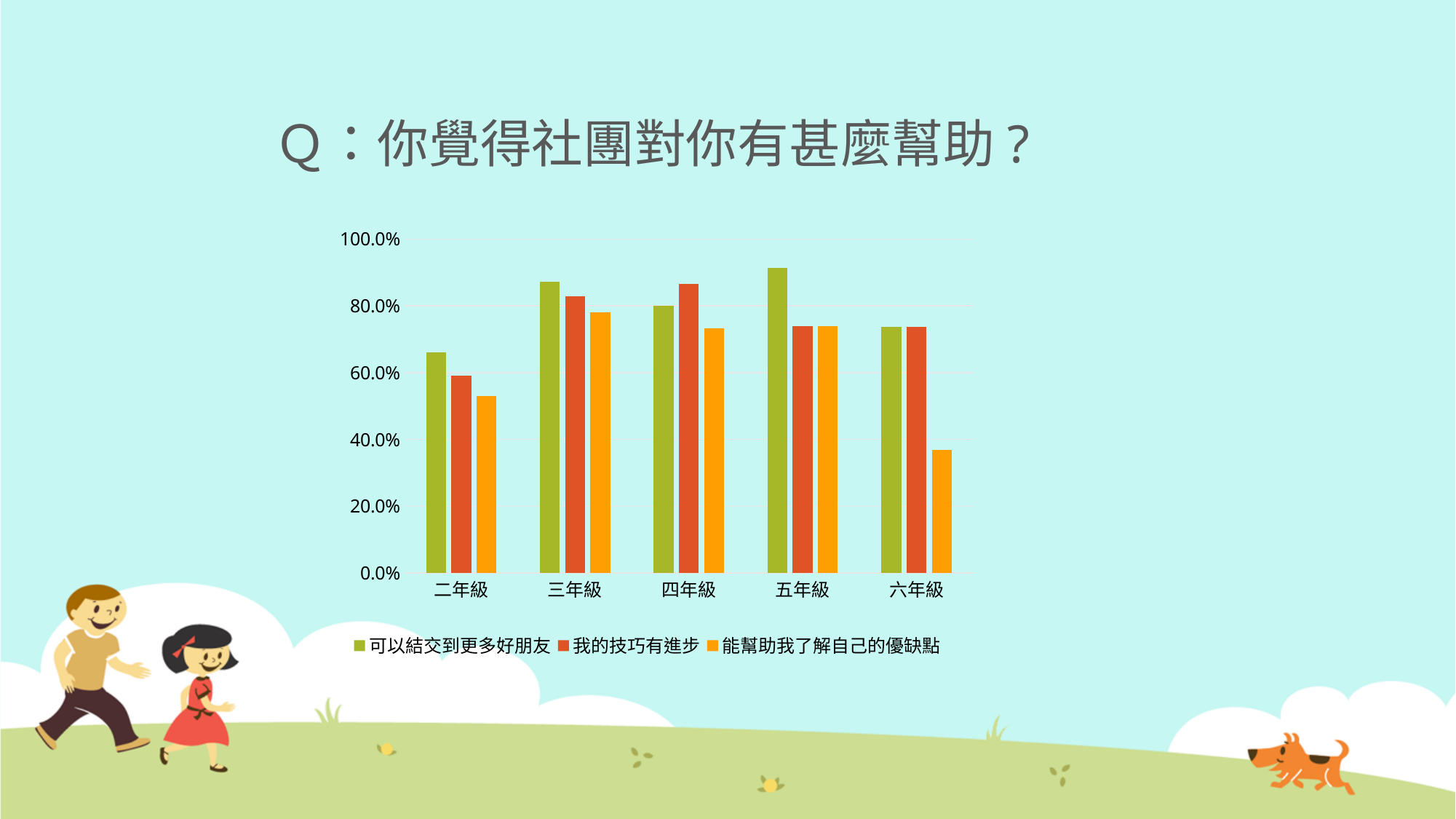
In 四年級, which is larger: 可以結交到更多好朋友 or 我的技巧有進步? 我的技巧有進步 How many grade categories are shown on the x axis? 5 Which grade has the lowest value for 能幫助我了解自己的優缺點? 六年級 Is the value for 能幫助我了解自己的優缺點 in 六年級 greater or less than 40.0%? less How many series does the legend list? 3 Is the value for 可以結交到更多好朋友 in 五年級 greater or less than 80.0%? greater Which grade has the highest value for 可以結交到更多好朋友? 五年級 What is the title of the slide above the chart? Q：你覺得社團對你有甚麼幫助？ In 二年級, which is larger: 可以結交到更多好朋友 or 能幫助我了解自己的優缺點? 可以結交到更多好朋友 Is the value for 能幫助我了解自己的優缺點 in 二年級 greater or less than 60.0%? less What kind of chart is shown on the slide? bar chart Which grade has the lowest value for 可以結交到更多好朋友? 二年級